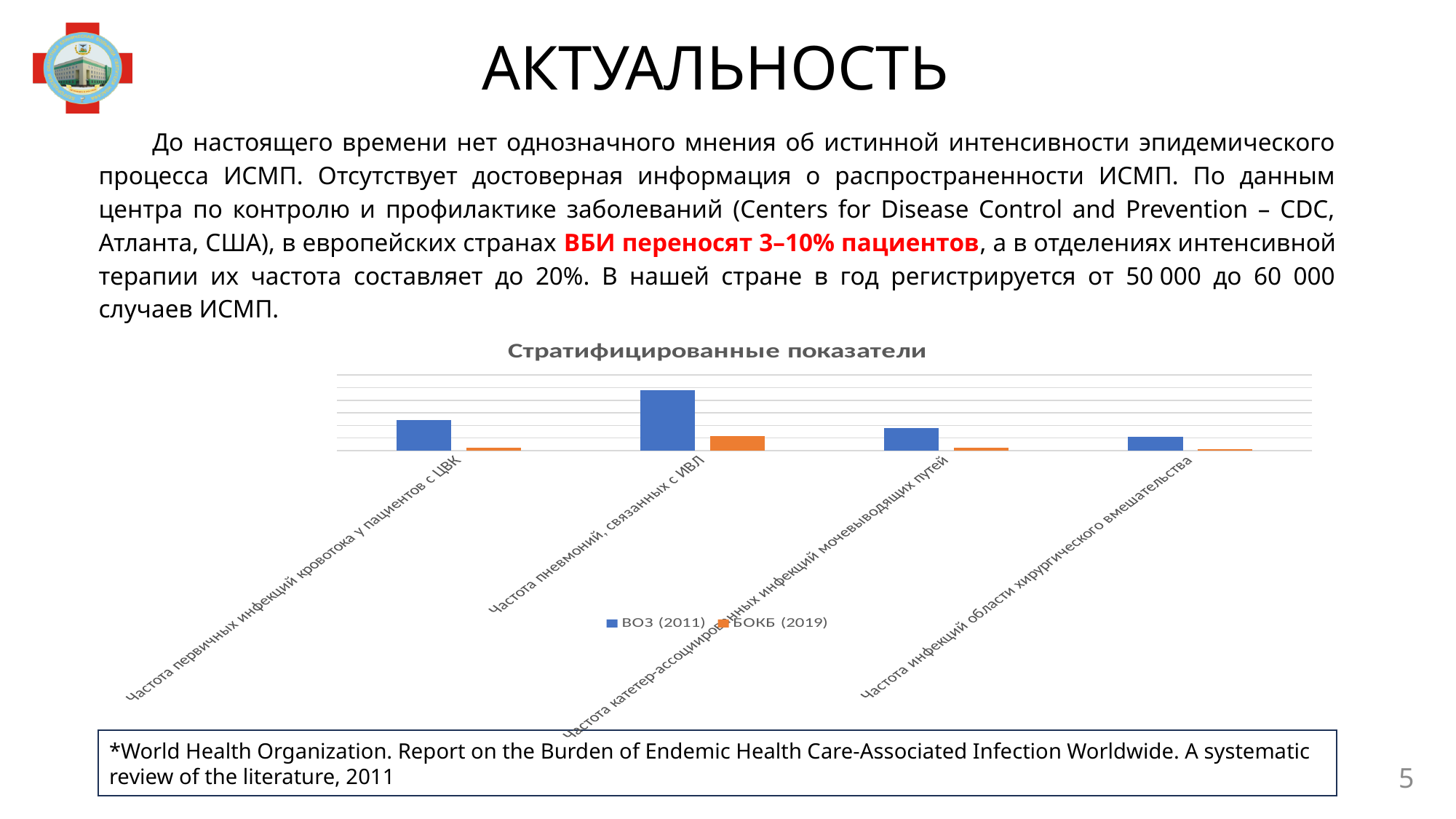
Which is larger for the БОКБ (2019) series: the value for 'Частота пневмоний, связанных с ИВЛ' or for 'Частота катетер-ассоциированных инфекций мочевыводящих путей'? Частота пневмоний, связанных с ИВЛ What kind of chart is shown on the slide? bar chart For which category is the ВОЗ (2011) value highest? Частота пневмоний, связанных с ИВЛ Which is larger for the ВОЗ (2011) series: the value for 'Частота пневмоний, связанных с ИВЛ' or for 'Частота инфекций области хирургического вмешательства'? Частота пневмоний, связанных с ИВЛ For the category 'Частота первичных инфекций кровотока у пациентов с ЦВК', which series has the larger value, ВОЗ (2011) or БОКБ (2019)? ВОЗ (2011) How many categories are shown on the x axis of the chart? 4 What is the title of the chart? Стратифицированные показатели How many series does the chart legend list? 2 Which series is shown in blue in the chart? ВОЗ (2011) For which category is the ВОЗ (2011) value lowest? Частота инфекций области хирургического вмешательства For which category is the БОКБ (2019) value highest? Частота пневмоний, связанных с ИВЛ